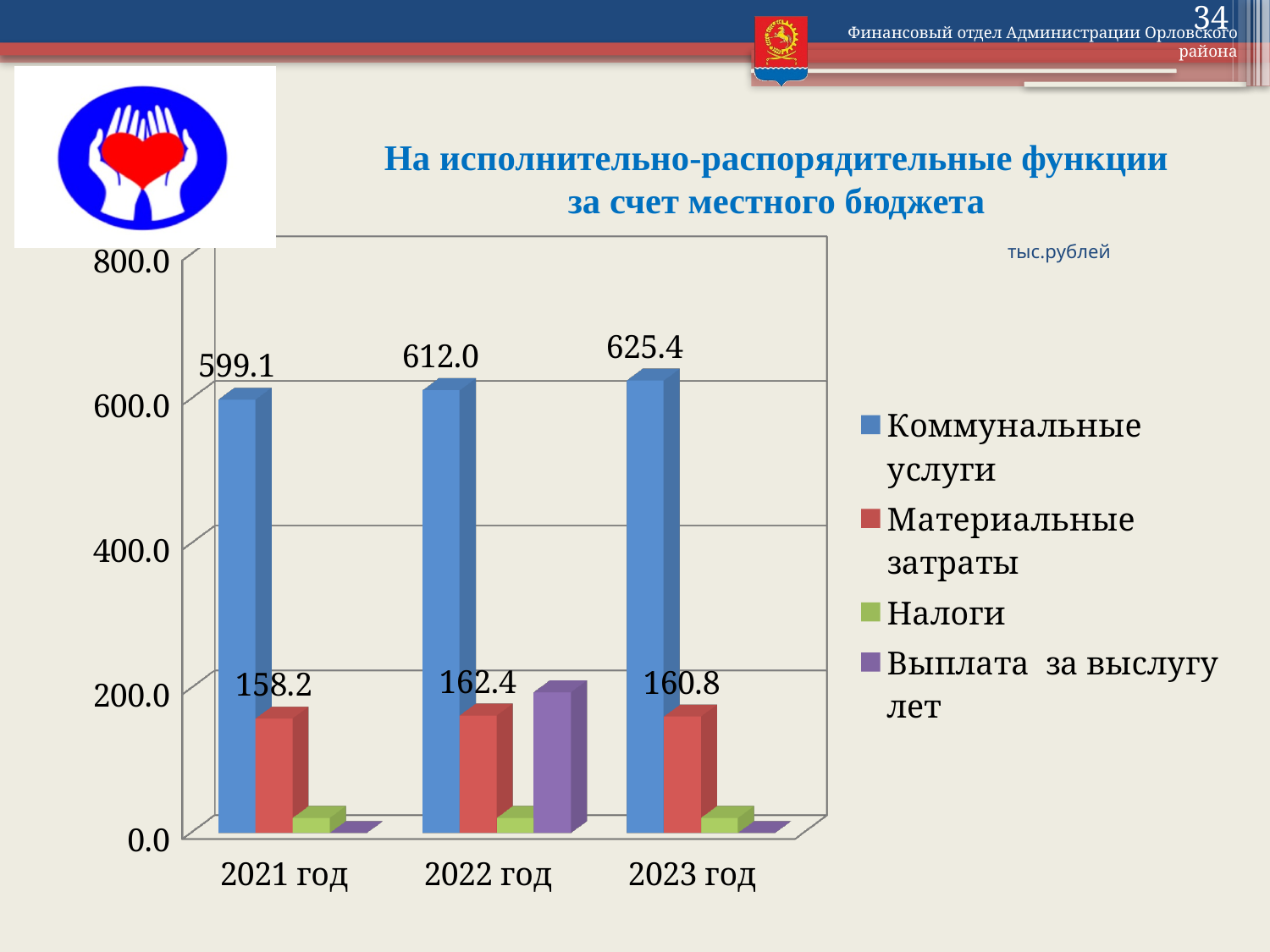
What is the difference between the Коммунальные услуги values for 2023 год and 2021 год? 26.3 In which year is the value for Коммунальные услуги the highest? 2023 год What is the value for Материальные затраты in 2022 год? 162.4 What is the value for Коммунальные услуги in 2023 год? 625.4 How many series does the legend list? 4 Which is larger in 2022 год: Коммунальные услуги or Материальные затраты? Коммунальные услуги Is the value for Выплата за выслугу лет in 2022 год greater or less than 400? less What is the value for Коммунальные услуги in 2021 год? 599.1 What is the value for Материальные затраты in 2023 год? 160.8 What type of chart is shown on the slide? bar chart Do the values for Коммунальные услуги rise or fall from 2021 год to 2023 год? rise In which year is the value for Материальные затраты the lowest? 2021 год